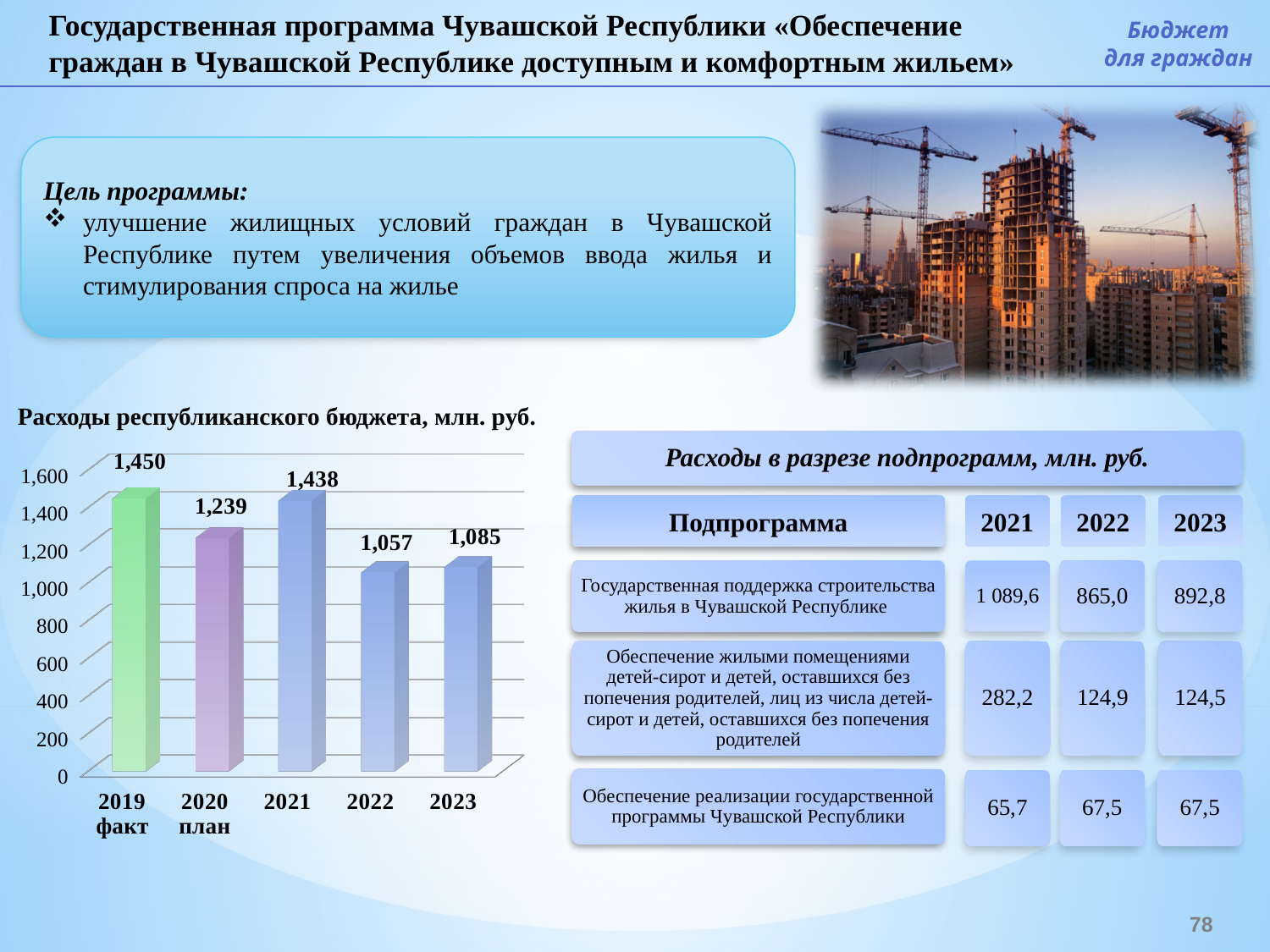
What is the value for 2019 факт in the chart 'Расходы республиканского бюджета, млн. руб.'? 1,450 What is the value for 2022 in the chart 'Расходы республиканского бюджета, млн. руб.'? 1,057 Which category has the lowest value in the chart 'Расходы республиканского бюджета, млн. руб.'? 2022 What is the difference between the values for 2021 and 2022 in the chart 'Расходы республиканского бюджета, млн. руб.'? 381 What is the title of the bar chart on the slide? Расходы республиканского бюджета, млн. руб. What is the value for 2020 план in the chart 'Расходы республиканского бюджета, млн. руб.'? 1,239 Is the value for 2023 in the chart 'Расходы республиканского бюджета, млн. руб.' greater or less than 1,200? less Which category has the highest value in the chart 'Расходы республиканского бюджета, млн. руб.'? 2019 факт Which is larger in the chart 'Расходы республиканского бюджета, млн. руб.': the value for 2020 план or the value for 2021? 2021 What kind of chart is 'Расходы республиканского бюджета, млн. руб.'? bar chart Does the value rise or fall from 2021 to 2022 in the chart 'Расходы республиканского бюджета, млн. руб.'? fall How many categories are shown on the x axis of the chart 'Расходы республиканского бюджета, млн. руб.'? 5